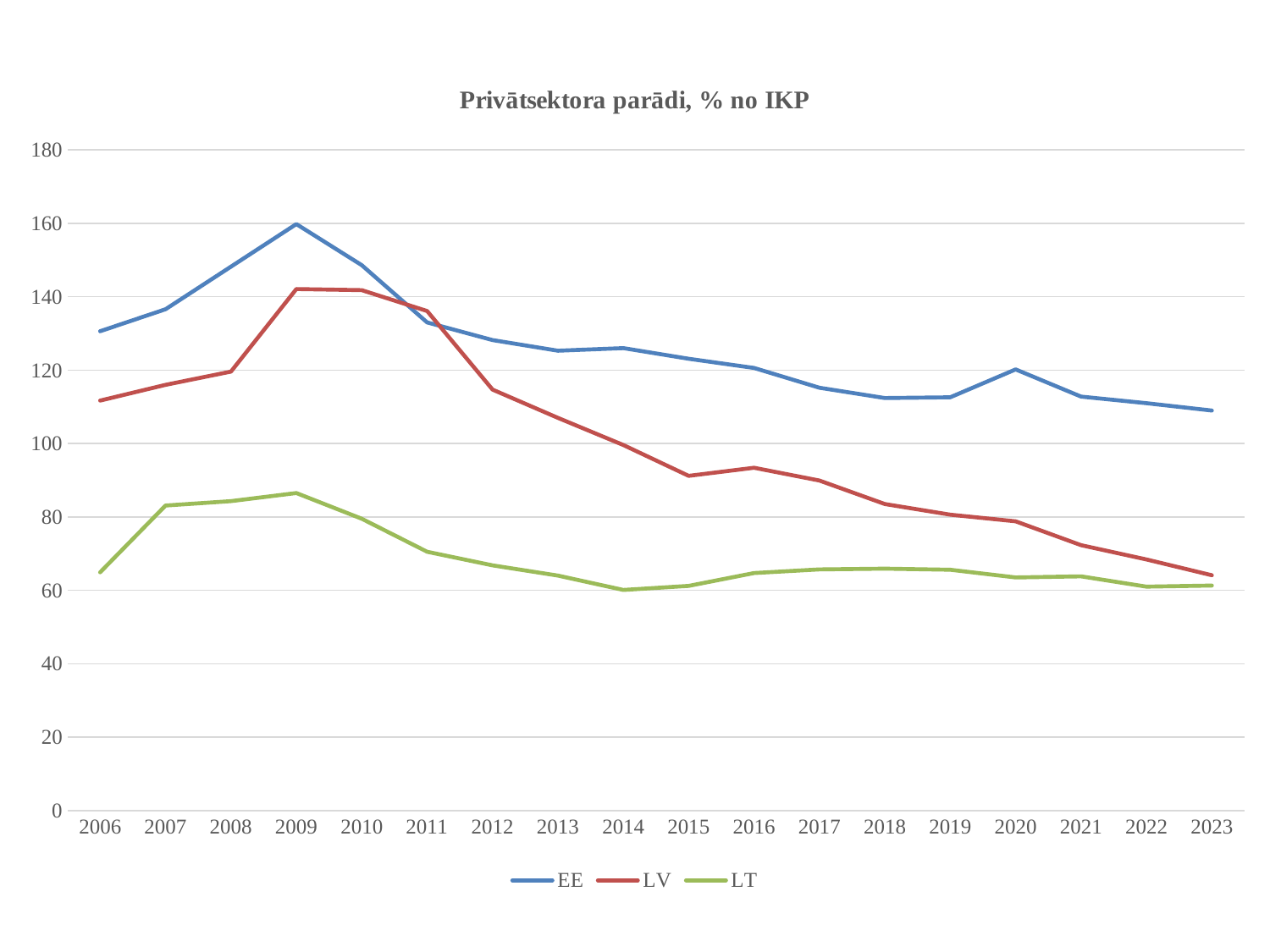
What is the title of the chart? Privātsektora parādi, % no IKP Is the value for EE in 2009 greater or less than 140? greater How many series does the legend list? 3 In which year does the EE series reach its highest value? 2009 What type of chart is shown on the slide? line chart Is the value for LV in 2023 greater or less than 80? less How many years are shown along the x axis? 18 In which year does the LV series reach its lowest value? 2023 Which series is shown with a green line? LT Is the value for EE in 2023 greater or less than 100? greater Does the LV series rise or fall between 2010 and 2023? fall In 2006, which series has the higher value, EE or LV? EE